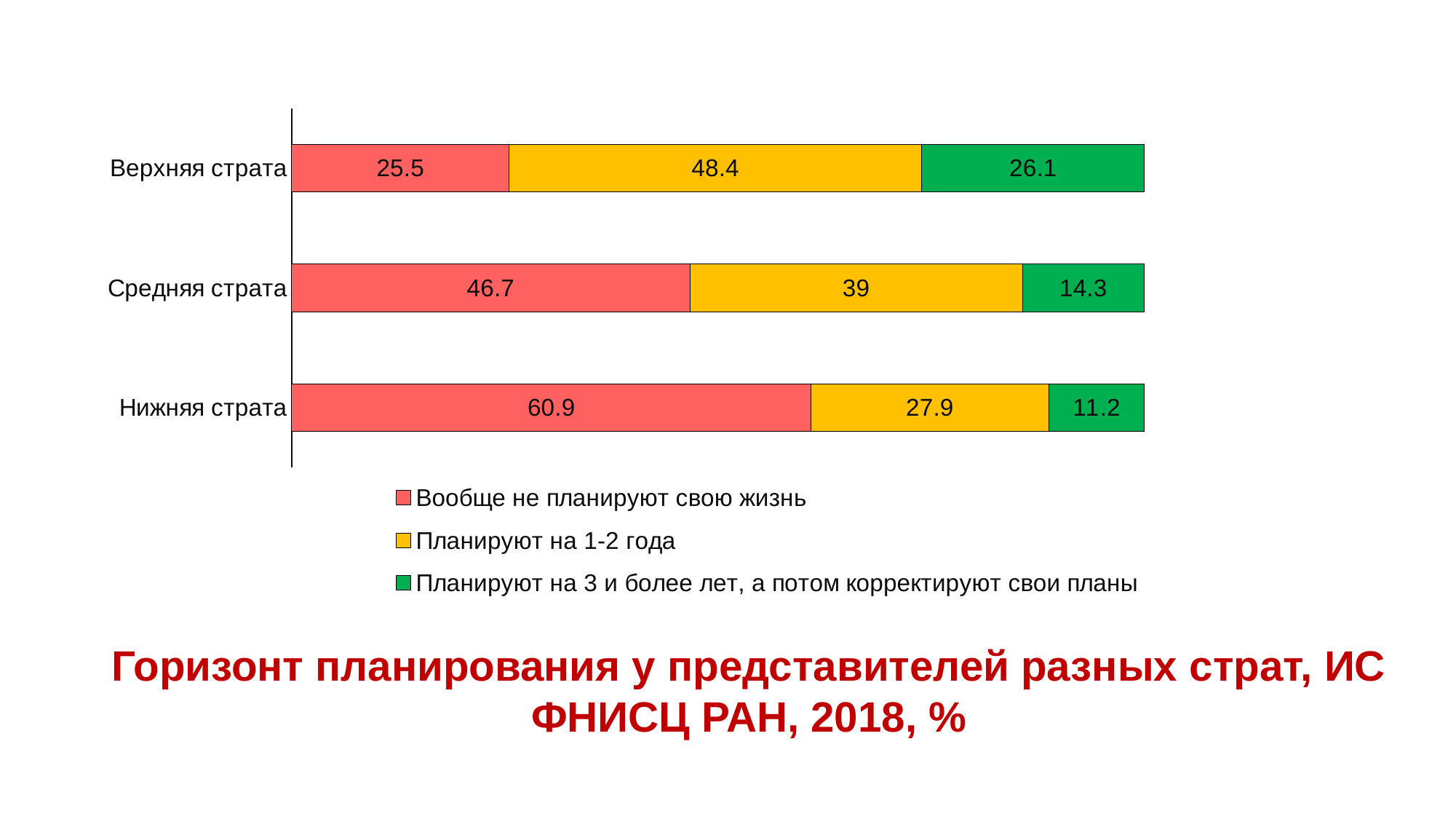
What is the value for "Планируют на 1-2 года" in the Верхняя страта bar? 48.4 Which stratum has the lowest value for "Планируют на 3 и более лет, а потом корректируют свои планы"? Нижняя страта What is the difference between the "Вообще не планируют свою жизнь" values for Нижняя страта and Верхняя страта? 35.4 Which colour represents "Планируют на 1-2 года" in the chart? Yellow What is the total of the Средняя страта stacked bar? 100 What is the value for "Планируют на 3 и более лет, а потом корректируют свои планы" in the Средняя страта bar? 14.3 What kind of chart is shown on the slide? Stacked bar chart Which stratum has the highest value for "Вообще не планируют свою жизнь"? Нижняя страта Which is larger: the "Планируют на 1-2 года" value for Средняя страта or for Нижняя страта? Средняя страта What is the value for "Вообще не планируют свою жизнь" in the Нижняя страта bar? 60.9 How many series does the legend list? 3 How many strata (categories) are shown in the chart? 3